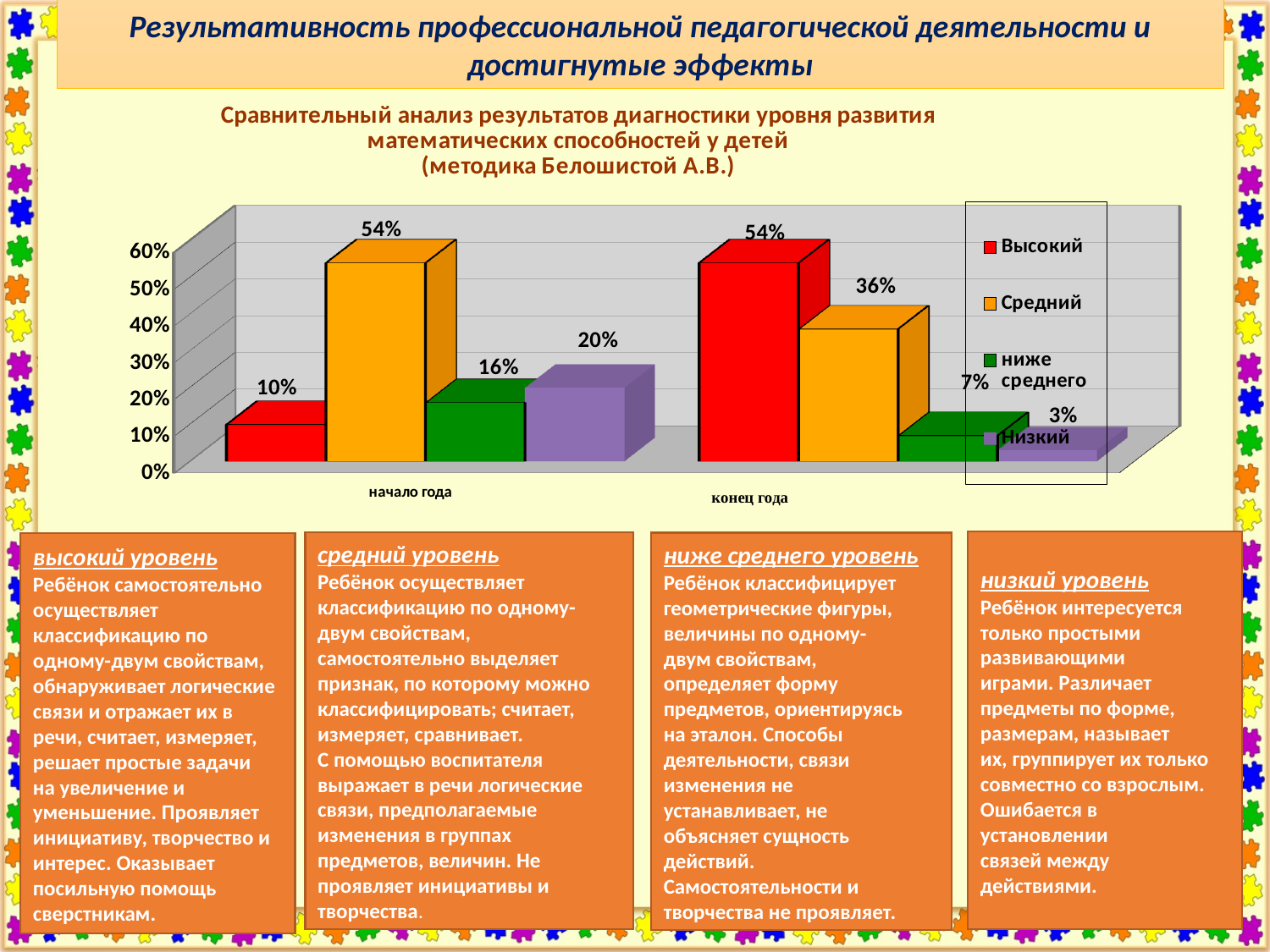
Каким цветом на диаграмме обозначена серия «Средний»? оранжевым Сколько категорий показано на оси x диаграммы? 2 Какое значение имеет серия «ниже среднего» в категории «начало года»? 16% Какое значение имеет серия «Высокий» в категории «начало года»? 10% На сколько процентных пунктов значение серии «Высокий» в конце года больше, чем в начале года? 44 Какого типа эта диаграмма? столбчатая (bar chart) Какое значение имеет серия «Средний» в категории «конец года»? 36% Сколько серий перечислено в легенде диаграммы? 4 Какая серия имеет наибольшее значение в категории «начало года»? Средний Какое значение имеет серия «Низкий» в категории «конец года»? 3% Что больше: значение серии «Низкий» в начале года или в конце года? в начале года Какая серия имеет наименьшее значение в категории «конец года»? Низкий